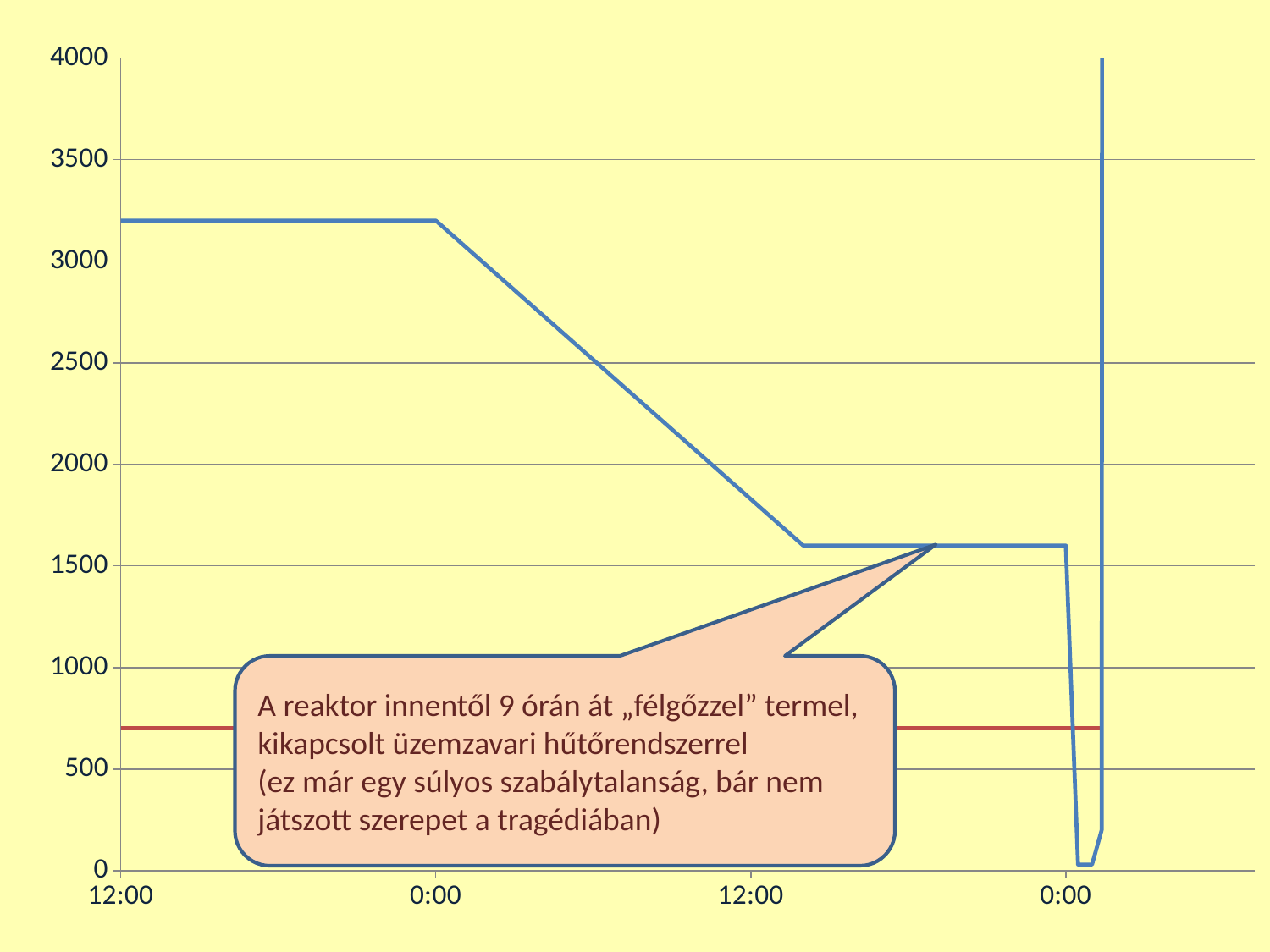
Is the value of the red horizontal line greater or less than 500? greater Is the value of the blue line at the first 12:00 label greater or less than 3500? less Is the value of the blue line at the first 12:00 label greater or less than 3000? greater How many lines are plotted on the chart? 2 What kind of chart is shown on the slide? line chart How many time labels are shown on the horizontal axis? 4 At the first 12:00 label, which line is higher, the blue line or the red line? the blue line What is the highest value shown on the vertical axis? 4000 Between the first 0:00 label and the second 12:00 label, does the blue line rise or fall? fall